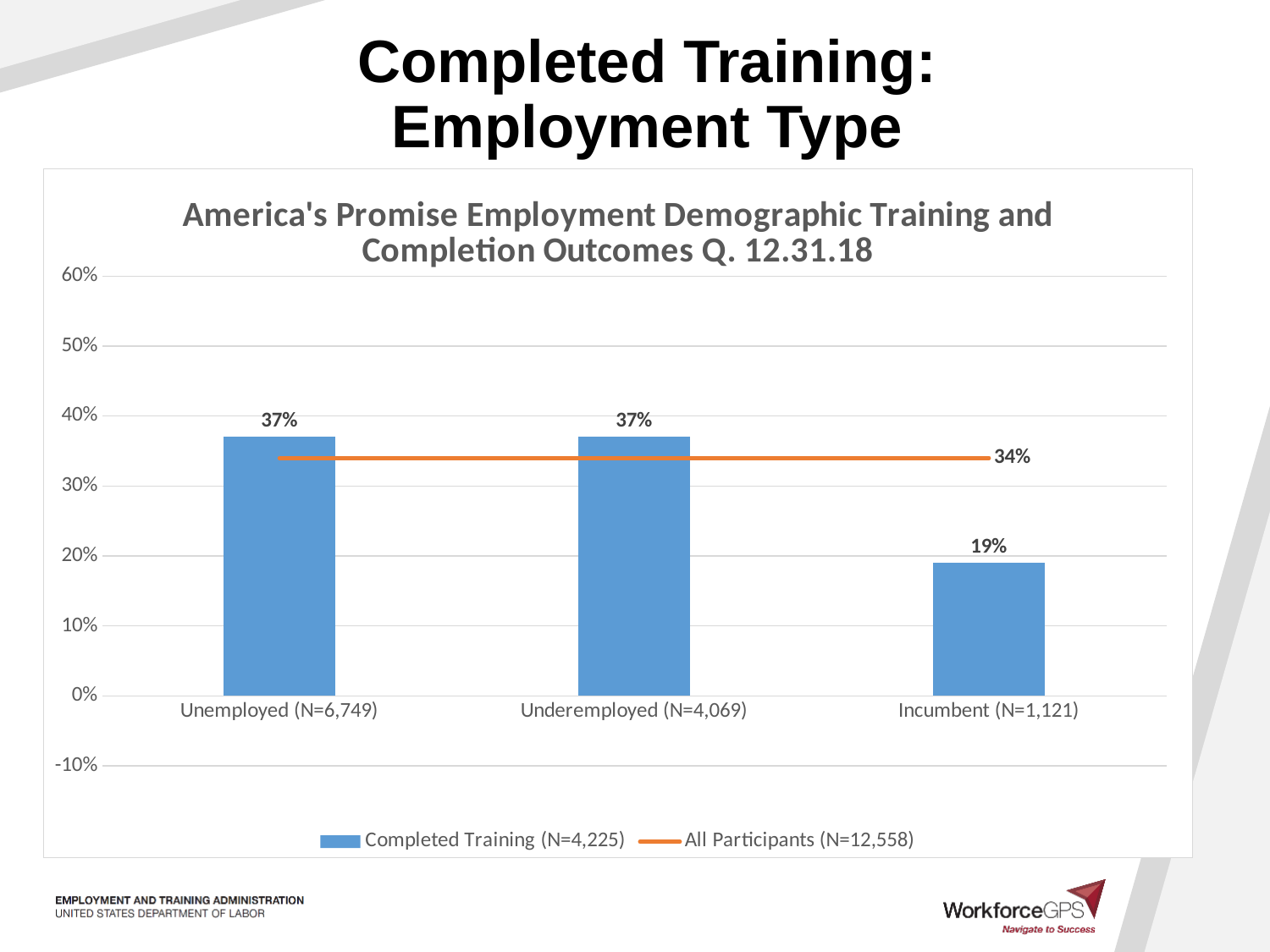
What is the Completed Training value for Underemployed (N=4,069)? 37% How many employment type categories are shown on the x axis? 3 What value is labelled on the All Participants (N=12,558) line? 34% How many series does the legend list? 2 Which employment type has the lowest Completed Training value? Incumbent (N=1,121) What is the Completed Training value for Incumbent (N=1,121)? 19% Which is larger: the Completed Training value for Underemployed (N=4,069) or for Incumbent (N=1,121)? Underemployed (N=4,069) Is the Completed Training value for Incumbent (N=1,121) greater or less than 30%? less What is the difference between the Completed Training values for Unemployed (N=6,749) and Incumbent (N=1,121)? 18% What is the title of the chart? America's Promise Employment Demographic Training and Completion Outcomes Q. 12.31.18 What kind of chart is used to show the Completed Training values? bar chart What is the Completed Training value for Unemployed (N=6,749)? 37%